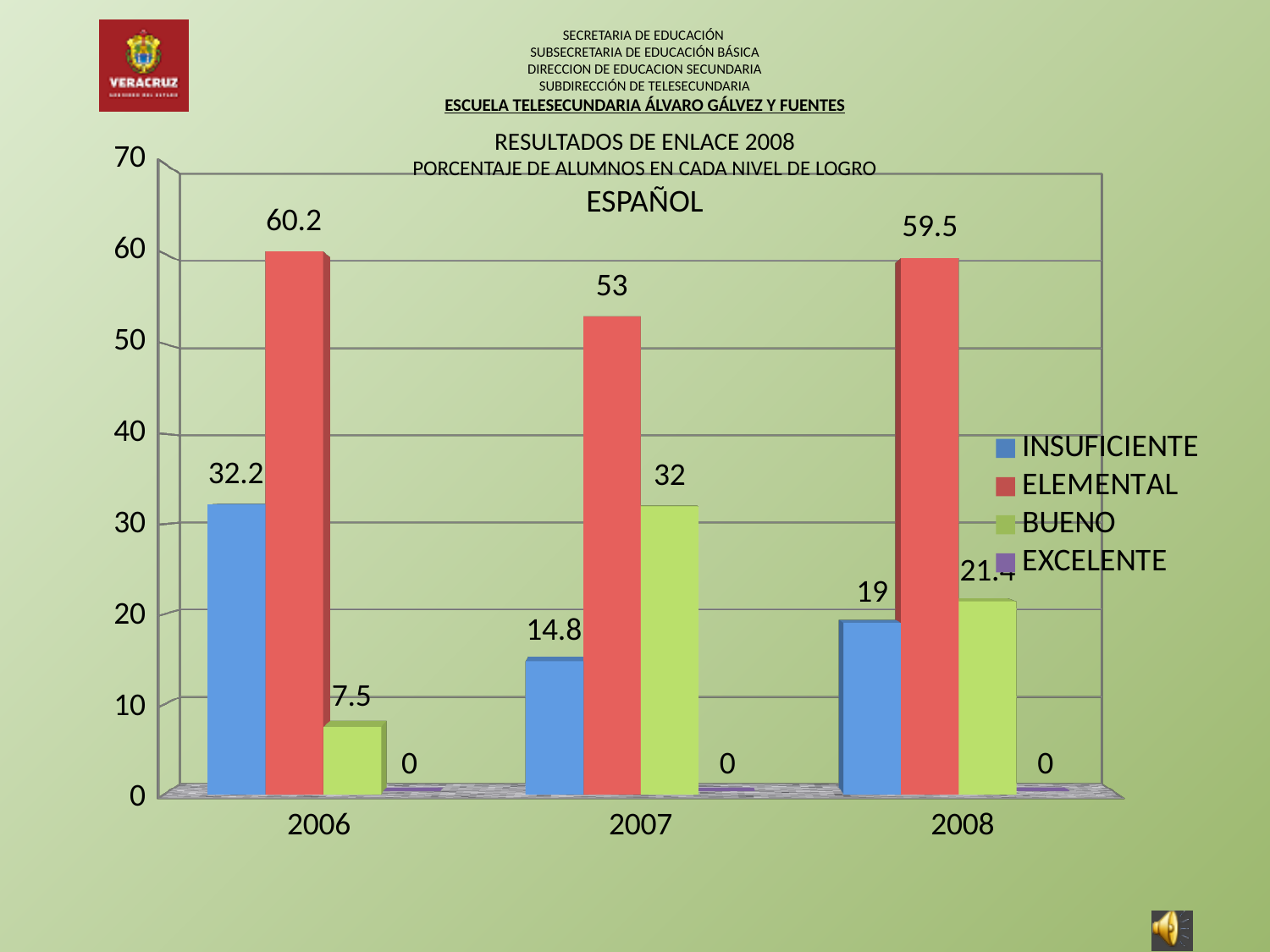
How many years are shown on the x axis? 3 How many series does the legend list? 4 What type of chart is shown on the slide? bar chart What is the EXCELENTE value for 2008? 0 Which year has the highest ELEMENTAL value? 2006 Which is larger, the BUENO value for 2006 or the BUENO value for 2007? 2007 Does the ELEMENTAL value rise or fall from 2006 to 2007? fall What is the difference between the INSUFICIENTE values for 2006 and 2008? 13.2 What is the INSUFICIENTE value for 2007? 14.8 What is the ELEMENTAL value for 2006? 60.2 Which year has the lowest INSUFICIENTE value? 2007 What is the BUENO value for 2007? 32